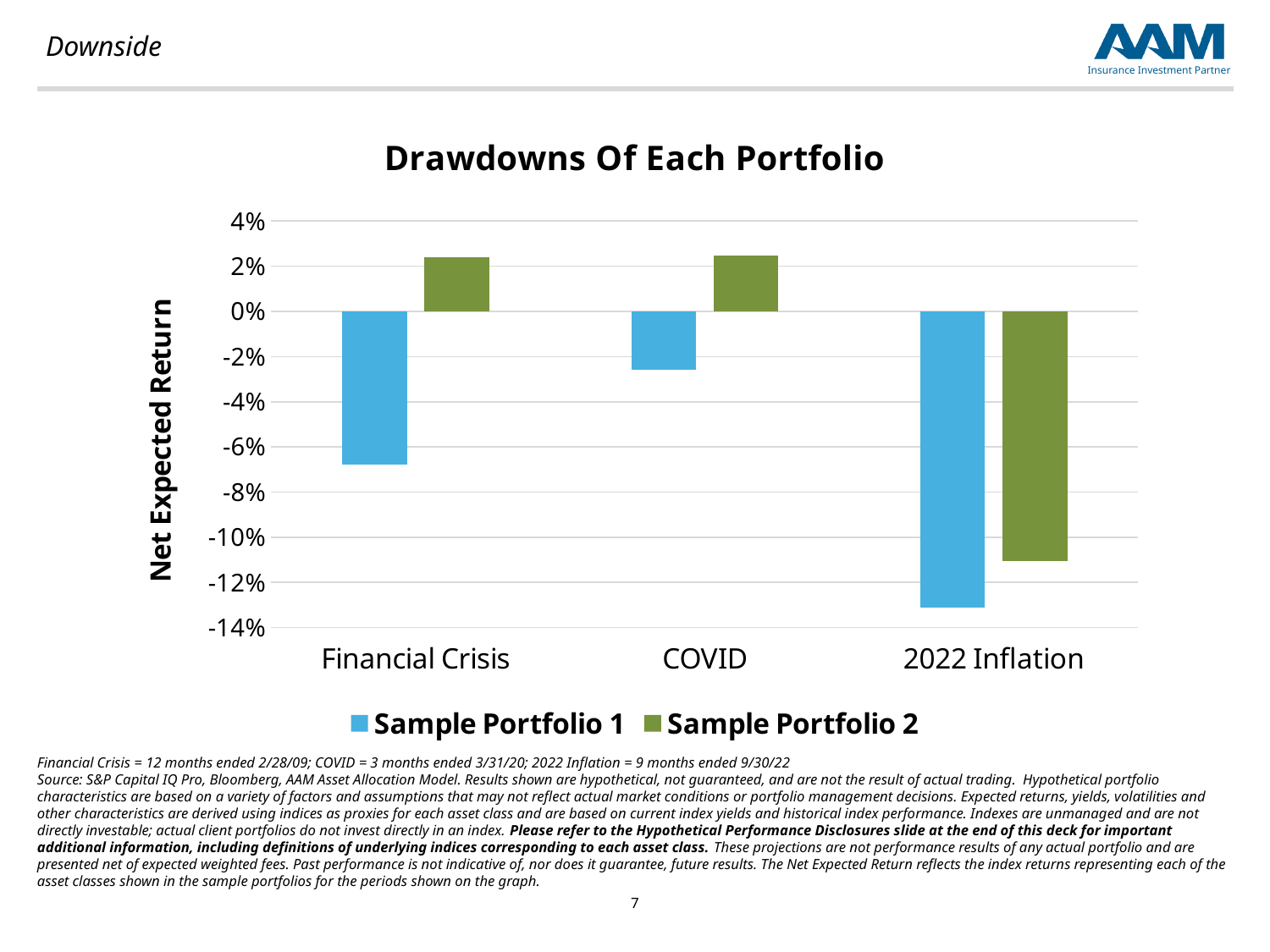
Which category has the lowest value for Sample Portfolio 1? 2022 Inflation Is the value for Sample Portfolio 2 in the Financial Crisis greater or less than 2%? greater What kind of chart is shown on the slide? bar chart Is the value for Sample Portfolio 2 in 2022 Inflation greater or less than -10%? less In 2022 Inflation, which portfolio has the higher value, Sample Portfolio 1 or Sample Portfolio 2? Sample Portfolio 2 How many categories are shown on the x axis? 3 What is the title of the chart? Drawdowns Of Each Portfolio How many series does the legend list? 2 What is the label of the y axis? Net Expected Return Which category has the highest value for Sample Portfolio 1? COVID Is the value for Sample Portfolio 1 in the Financial Crisis greater or less than -6%? less